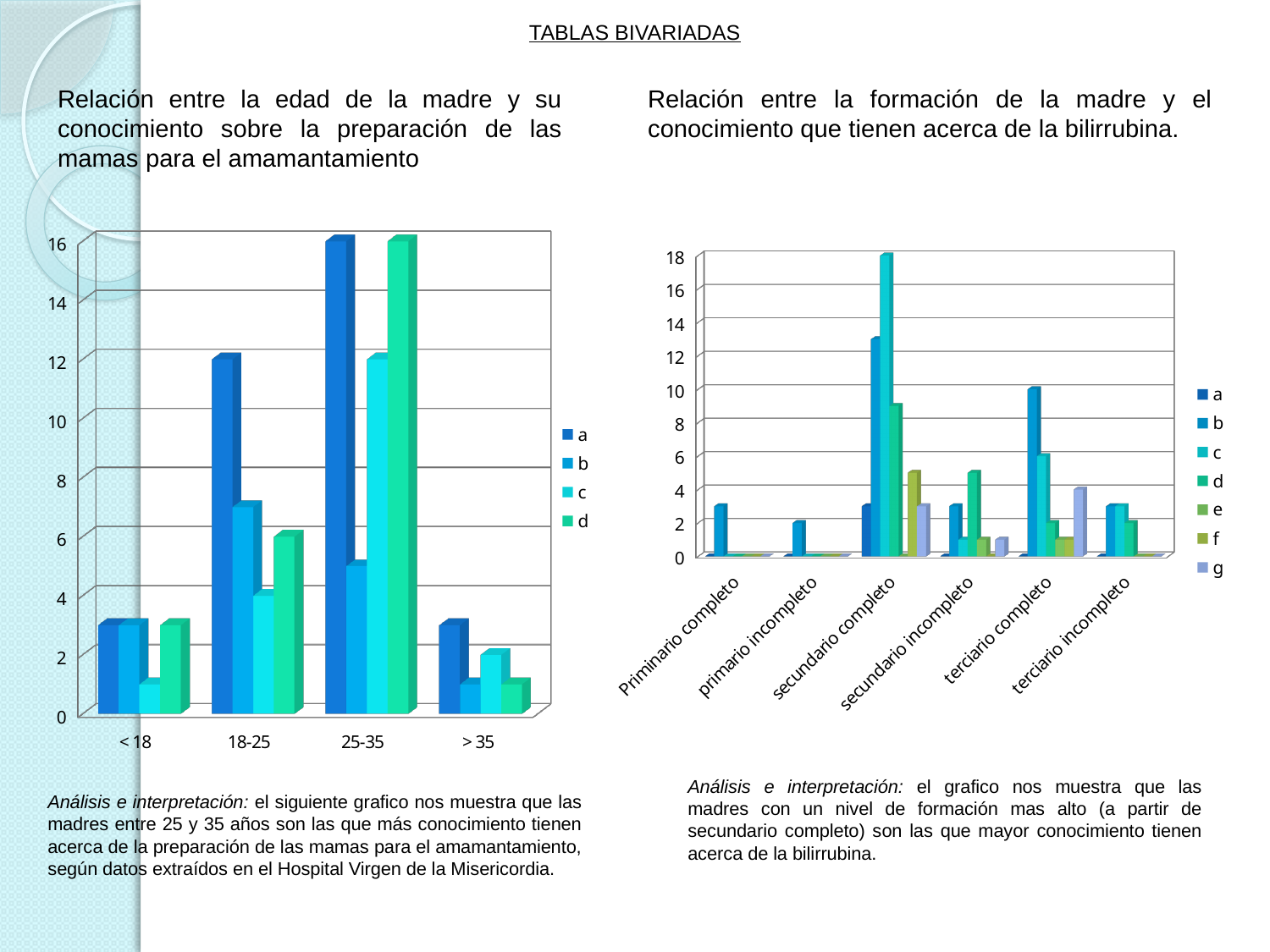
How many series does the legend of the right chart (formación de la madre) list? 7 In the left chart, is the value for series c in the 18-25 group greater or less than 6? less How many education categories are shown on the x axis of the right chart? 6 In the right chart, is the value for series c in secundario completo greater or less than 16? greater What kind of chart is the left chart (relación entre la edad de la madre)? bar chart In the left chart, is the value for series a in the 18-25 group greater or less than 10? greater How many series does the legend of the left chart list? 4 In the left chart, which age group contains the tallest bar? 25-35 In the right chart, which education category contains the tallest bar? secundario completo In the left chart, for the 18-25 group, which is larger: series a or series c? a In the right chart, for terciario completo, which is larger: series b or series c? b How many age groups are shown on the x axis of the left chart? 4